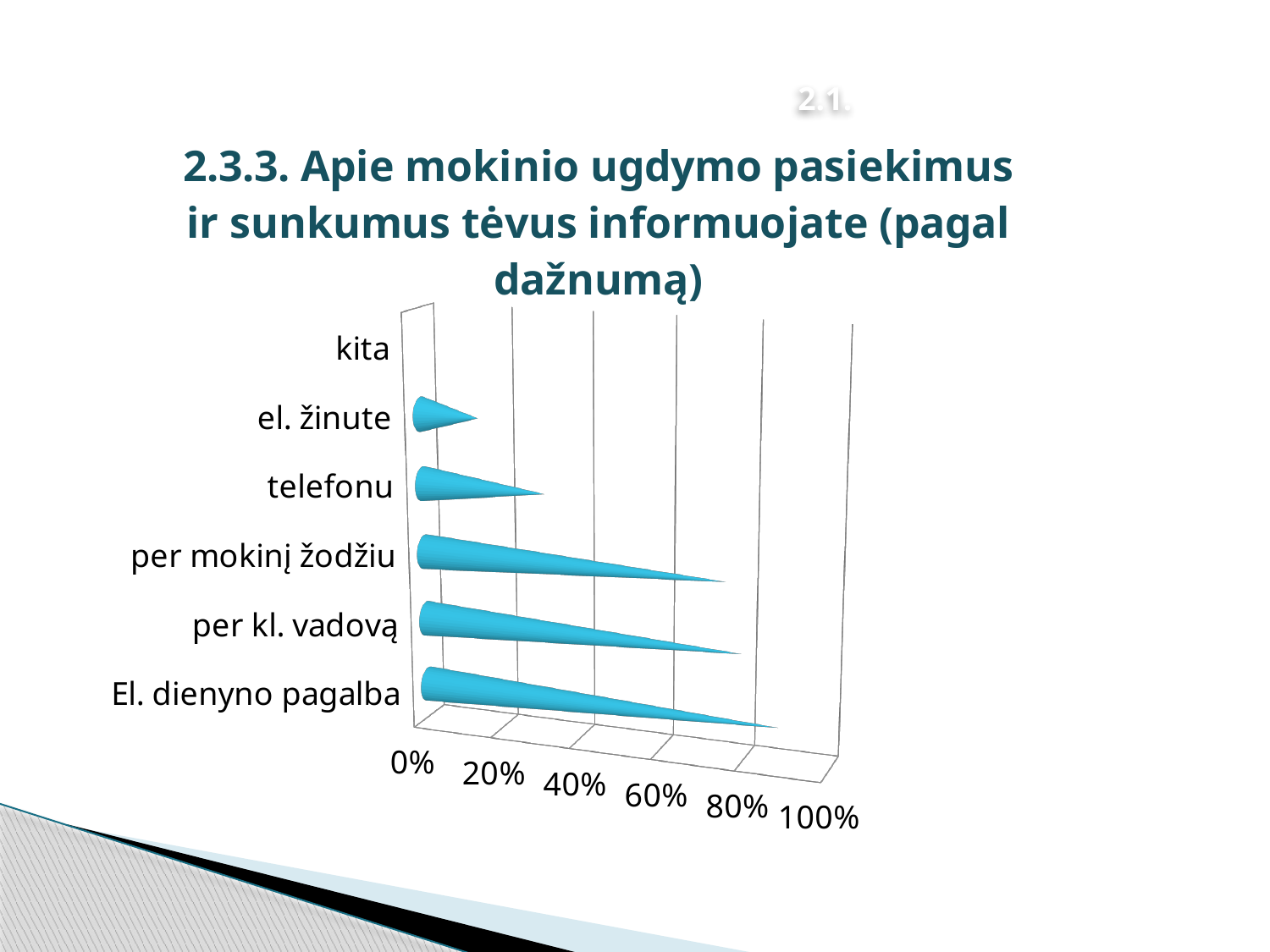
What kind of chart is shown on the slide? bar chart Is the value for per mokinį žodžiu greater or less than 40%? greater Which is larger, the value for per mokinį žodžiu or the value for telefonu? per mokinį žodžiu Which is larger, the value for telefonu or the value for el. žinute? telefonu Is the value for El. dienyno pagalba greater or less than 60%? greater Which category has the lowest value? el. žinute Is the value for per kl. vadovą greater or less than 60%? greater What is the highest percentage shown on the value axis? 100% Which category has the highest value? El. dienyno pagalba How many categories are shown on the chart? 6